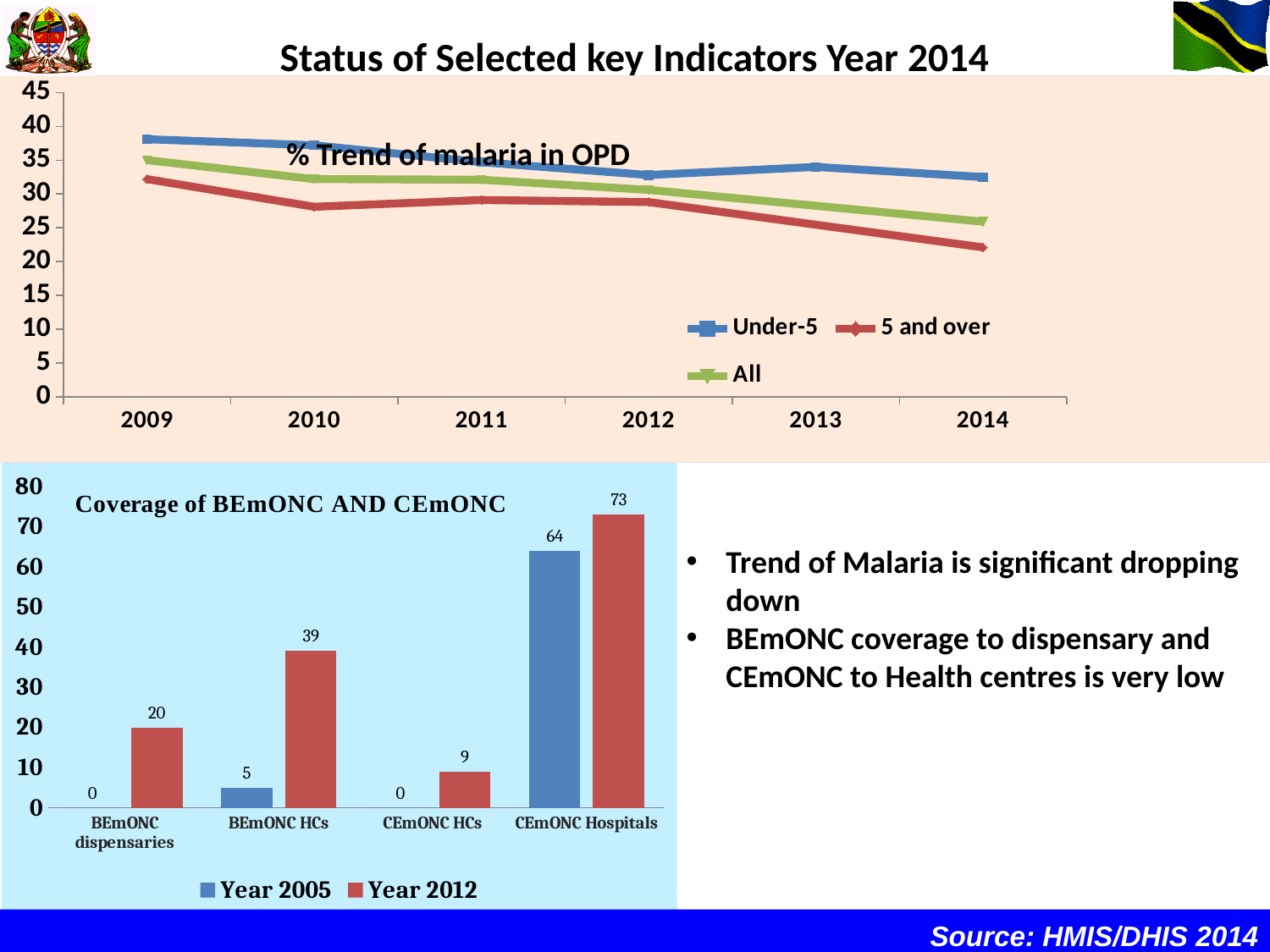
In the Coverage of BEmONC AND CEmONC chart, what is the Year 2005 value for BEmONC HCs? 5 In the % Trend of malaria in OPD chart, does the 5 and over series rise or fall from 2009 to 2014? Fall In the Coverage of BEmONC AND CEmONC chart, what is the difference between the Year 2012 values for BEmONC HCs and BEmONC dispensaries? 19 In the Coverage of BEmONC AND CEmONC chart, what is the difference between the Year 2012 and Year 2005 values for CEmONC Hospitals? 9 In the Coverage of BEmONC AND CEmONC chart, which category has the highest Year 2012 value? CEmONC Hospitals In the Coverage of BEmONC AND CEmONC chart, what is the Year 2012 value for CEmONC HCs? 9 What kind of chart is the % Trend of malaria in OPD chart? Line chart In the Coverage of BEmONC AND CEmONC chart, what is the Year 2012 value for CEmONC Hospitals? 73 How many series does the legend of the Coverage of BEmONC AND CEmONC chart list? 2 How many categories are shown on the x axis of the Coverage of BEmONC AND CEmONC chart? 4 In the Coverage of BEmONC AND CEmONC chart, which is larger: the Year 2012 value for BEmONC HCs or the Year 2012 value for BEmONC dispensaries? BEmONC HCs In the % Trend of malaria in OPD chart, is the Under-5 value for 2009 greater or less than 35? greater